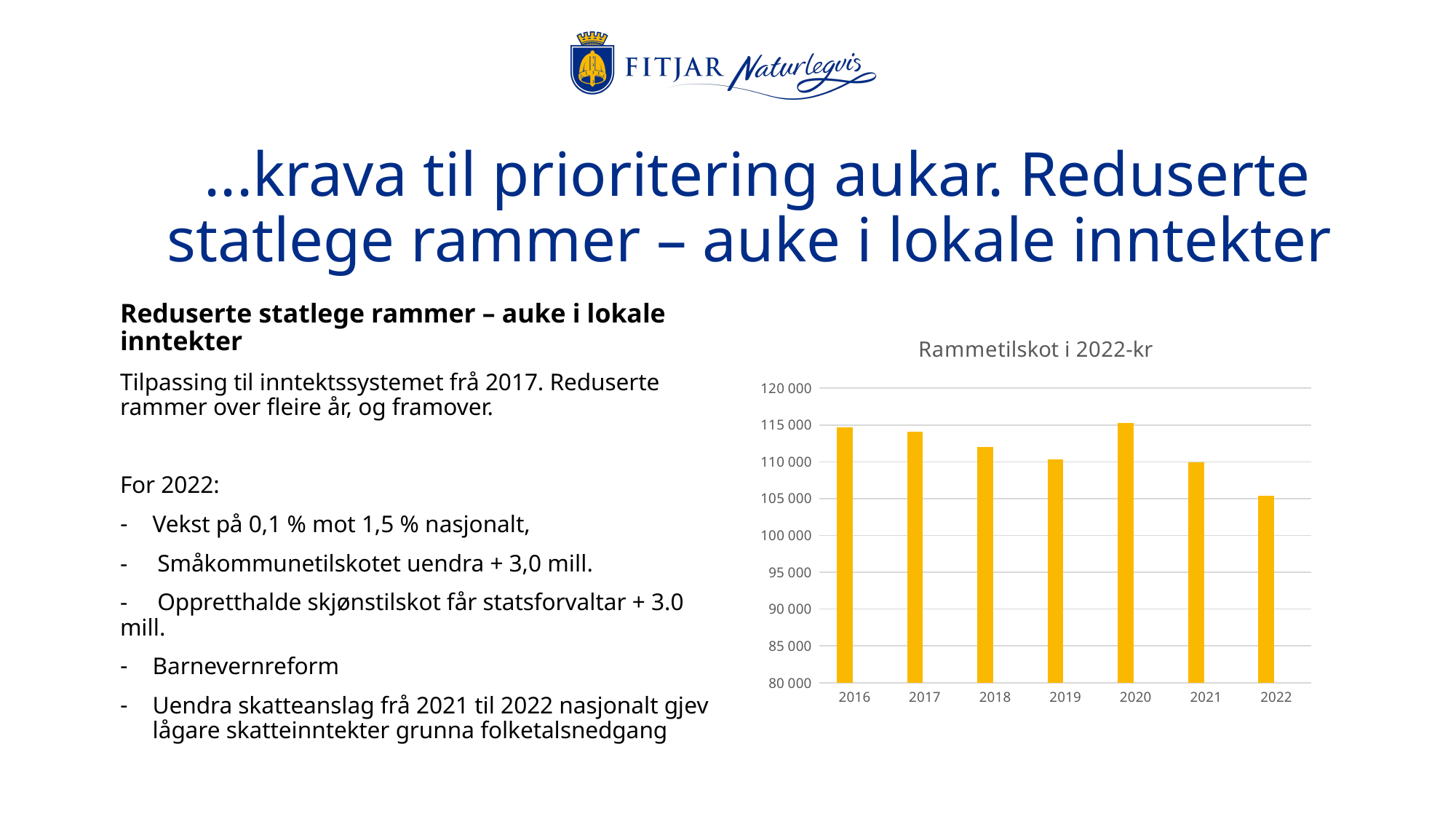
Which year has the lowest bar in the chart? 2022 Is the value for 2022 greater or less than 110 000? less What type of chart is shown on the slide? Bar chart Is the value for 2018 greater or less than 110 000? greater How many years are shown on the x axis of the chart? 7 Is the value for 2019 greater or less than 105 000? greater What is the title of the chart? Rammetilskot i 2022-kr Overall, do the values rise or fall from 2016 to 2022? fall Which year has the larger value, 2018 or 2019? 2018 Which year has the larger value, 2016 or 2022? 2016 Which year has the highest bar in the chart? 2020